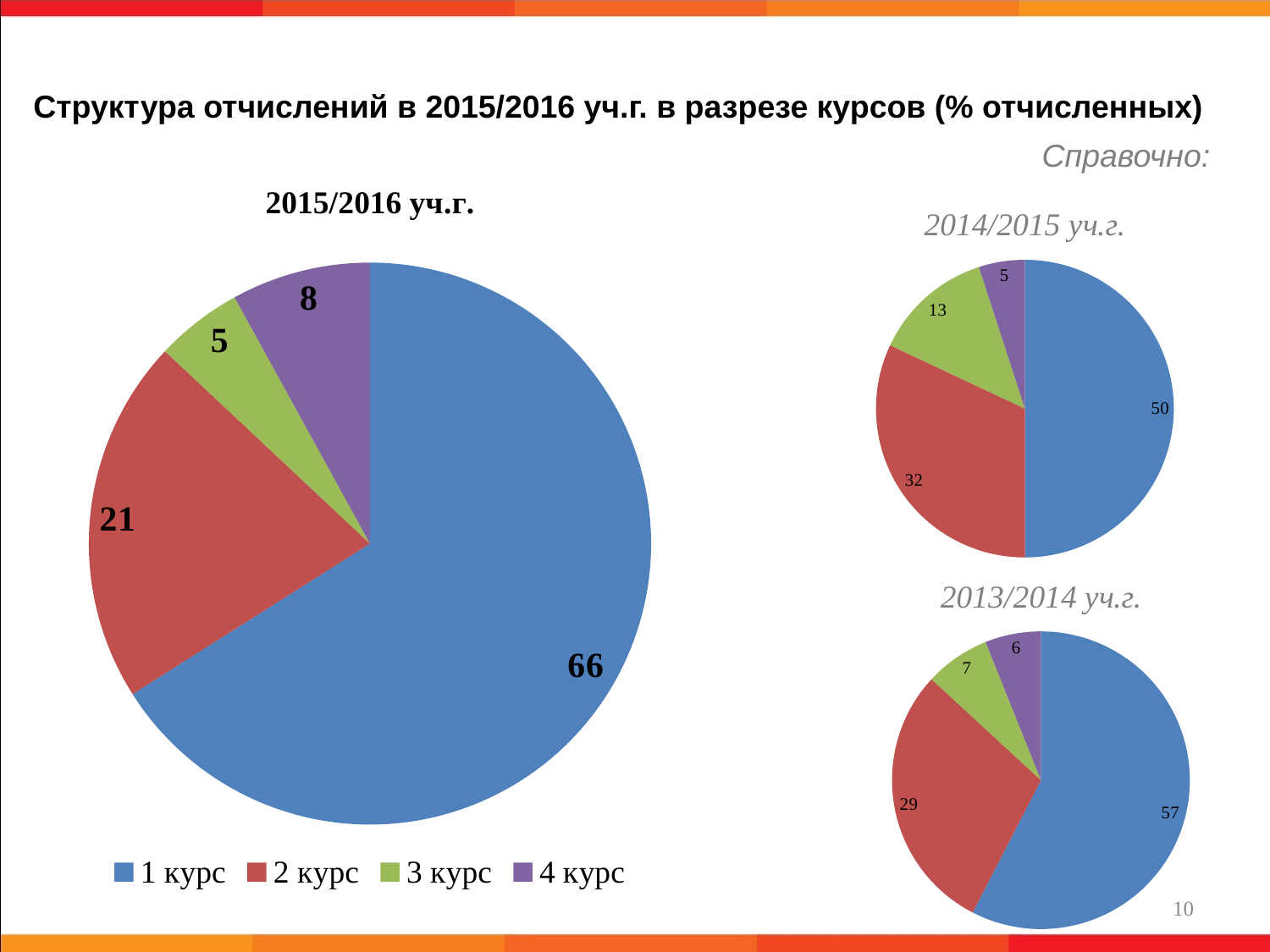
In the 2013/2014 уч.г. pie chart, which slice is the largest? 1 курс (57) How many entries does the legend under the 2015/2016 уч.г. chart list? 4 In the 2015/2016 уч.г. pie chart, what is the value for 1 курс? 66 In the 2013/2014 уч.г. pie chart, what is the value of the red slice (2 курс)? 29 How many slices does the 2015/2016 уч.г. pie chart have? 4 What type of chart is used for 2014/2015 уч.г.? Pie chart In the 2015/2016 уч.г. pie chart, what is the difference between the values for 1 курс and 2 курс? 45 In the 2015/2016 уч.г. pie chart, what is the value for 2 курс? 21 In the 2015/2016 уч.г. pie chart, which is larger: the value for 4 курс or the value for 3 курс? 4 курс In the 2014/2015 уч.г. pie chart, what is the value of the green slice (3 курс)? 13 In the 2014/2015 уч.г. pie chart, what is the value of the blue slice (1 курс)? 50 In the 2015/2016 уч.г. pie chart, which course has the smallest slice? 3 курс